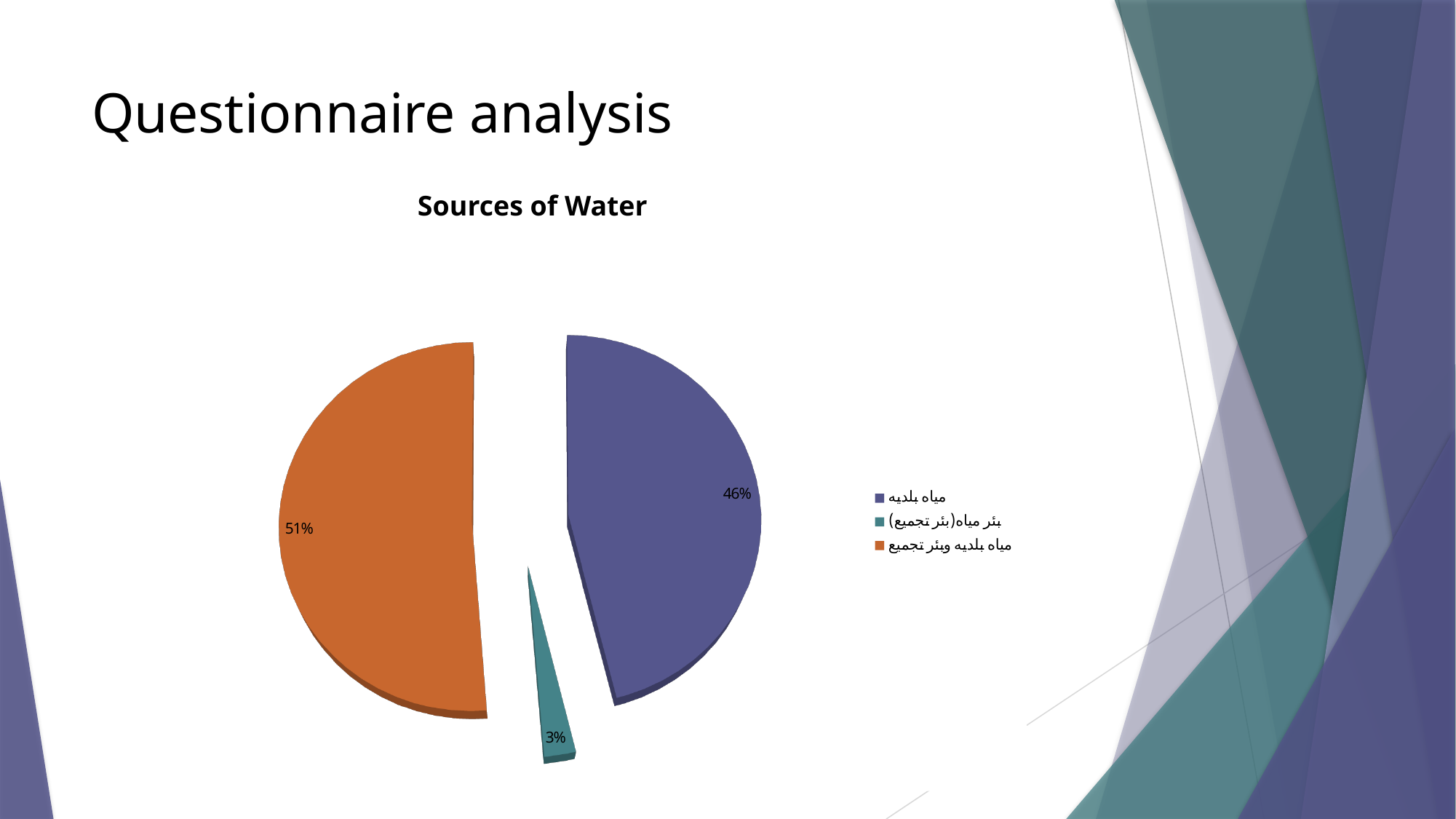
What share of the pie is labelled for بئر مياه(بئر تجميع)? 3% Which category has the smallest slice of the pie? بئر مياه(بئر تجميع) What share of the pie is labelled for مياه بلديه وبئر تجميع? 51% How many slices does the pie chart have? 3 What colour is the slice for مياه بلديه وبئر تجميع? orange How many entries does the legend list? 3 Which is larger, the slice for مياه بلديه or the slice for بئر مياه(بئر تجميع)? مياه بلديه Which category has the largest slice of the pie? مياه بلديه وبئر تجميع What is the difference in percentage points between the مياه بلديه وبئر تجميع slice and the مياه بلديه slice? 5 What share of the pie is labelled for مياه بلديه? 46% What is the title of the chart? Sources of Water What kind of chart is shown on the slide? pie chart